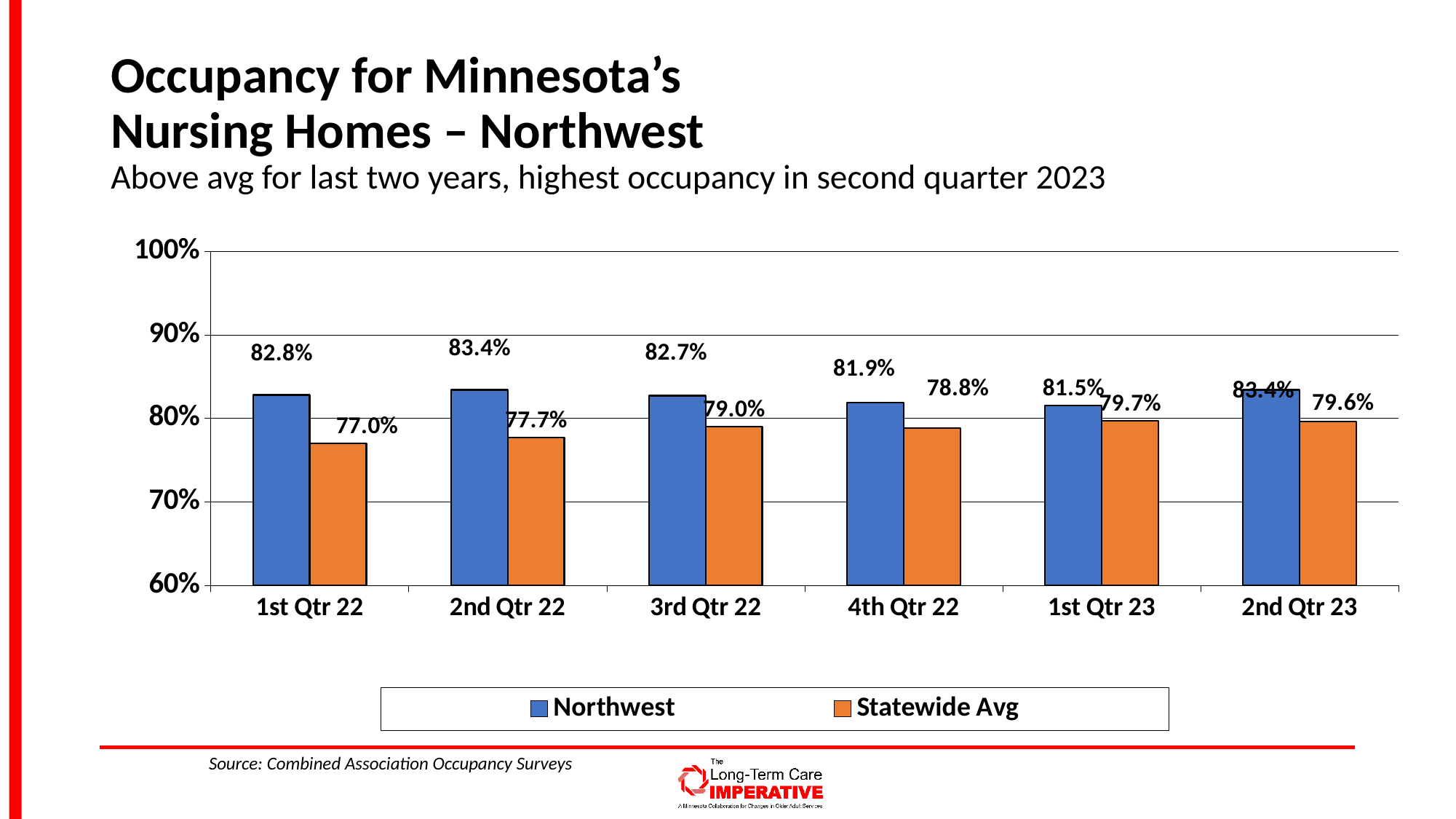
In which quarter is the Northwest occupancy lowest? 1st Qtr 23 What is the difference between the Northwest and Statewide Avg values in 1st Qtr 22? 5.8 percentage points What kind of chart is shown on the slide? Bar chart What is the Statewide Avg occupancy value for 1st Qtr 23? 79.7% What is the Northwest occupancy value for 1st Qtr 22? 82.8% How many quarters are shown on the x axis? 6 Is the Statewide Avg value for 1st Qtr 22 greater or less than 80%? less In which quarter is the Statewide Avg occupancy lowest? 1st Qtr 22 Which is larger in 2nd Qtr 23, the Northwest value or the Statewide Avg value? Northwest What is the Statewide Avg occupancy value for 3rd Qtr 22? 79.0% How many series does the legend list? 2 What is the Northwest occupancy value for 4th Qtr 22? 81.9%